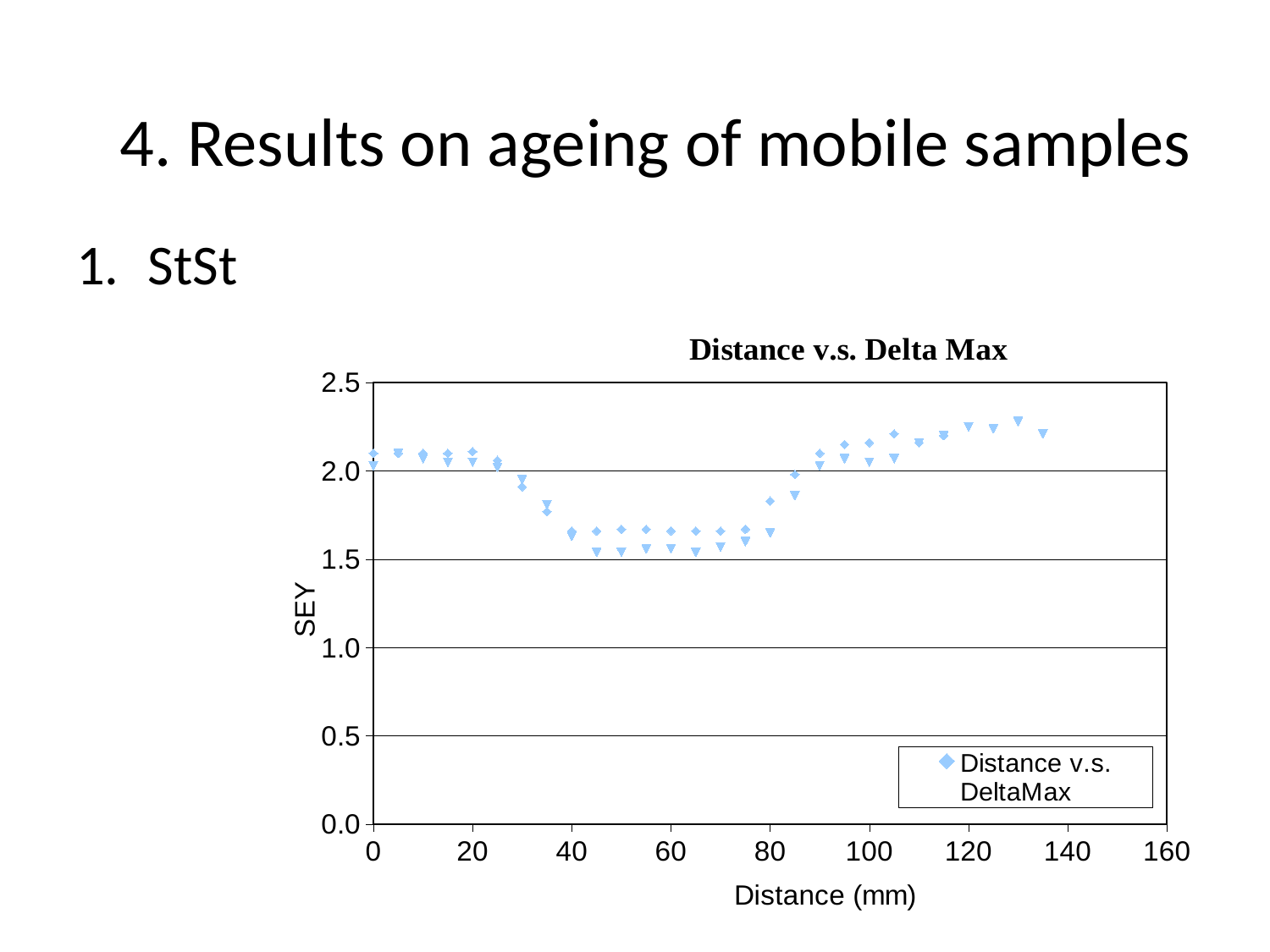
What kind of chart is shown on the slide? scatter chart Do the values rise or fall as the distance increases from 20 mm to 50 mm? fall Which has the larger value, the point at 10 mm or the point at 60 mm? 10 mm Is the value for a distance of 60 mm greater or less than 1.0? greater How many series does the legend list? 1 Is the value for a distance of 0 mm greater or less than 2.0? greater What is the label of the y axis? SEY Is the value for a distance of 50 mm greater or less than 2.0? less Do the values rise or fall as the distance increases from 80 mm to 130 mm? rise What is the title of the chart? Distance v.s. Delta Max